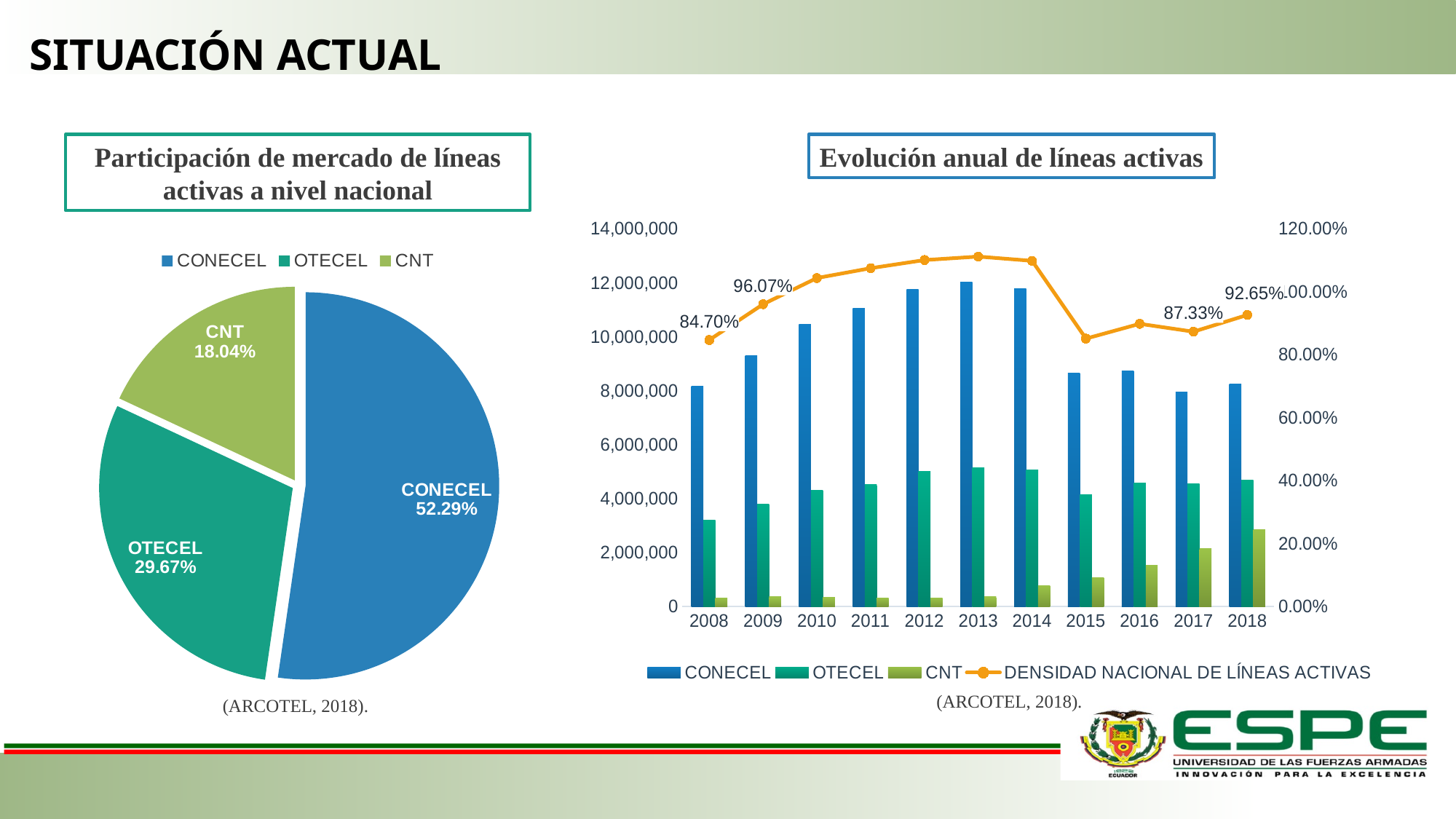
In the 'Evolución anual de líneas activas' chart, how many series does the legend list? 4 In the 'Evolución anual de líneas activas' chart, what is the value of DENSIDAD NACIONAL DE LÍNEAS ACTIVAS in 2018? 92.65% In the 'Evolución anual de líneas activas' chart, what is the value of DENSIDAD NACIONAL DE LÍNEAS ACTIVAS in 2008? 84.70% In the 'Evolución anual de líneas activas' chart, how many years are shown on the x axis? 11 In the 'Participación de mercado de líneas activas a nivel nacional' chart, what is the difference in percentage points between CONECEL and OTECEL? 22.62 In the 'Evolución anual de líneas activas' chart, which year has the highest CONECEL bar? 2013 In the 'Participación de mercado de líneas activas a nivel nacional' chart, which operator has the smallest share? CNT What kind of chart is 'Participación de mercado de líneas activas a nivel nacional'? Pie chart In the 'Participación de mercado de líneas activas a nivel nacional' chart, what share does CONECEL have? 52.29% In the 'Participación de mercado de líneas activas a nivel nacional' chart, what share does CNT have? 18.04% In the 'Evolución anual de líneas activas' chart, do the CNT bars rise or fall from 2014 to 2018? Rise